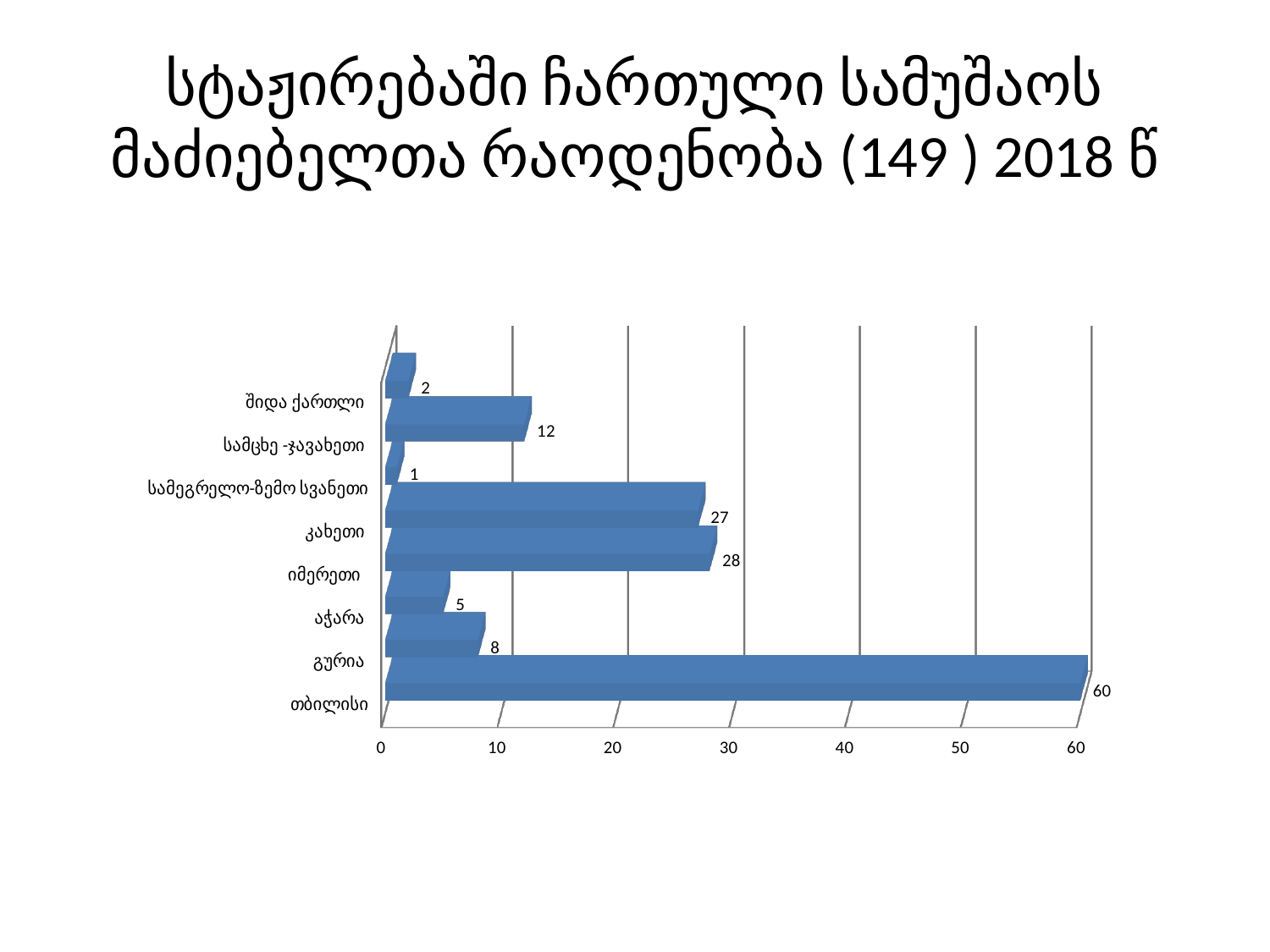
Which category has the lowest value? სამეგრელო-ზემო სვანეთი What is the value for სამცხე-ჯავახეთი? 12 What is the value for გურია? 8 What is the value for იმერეთი? 28 Is the value for კახეთი greater or less than 20? greater What is the value for თბილისი? 60 Which category has the highest value? თბილისი What is the difference between the values for თბილისი and იმერეთი? 32 What type of chart is shown on the slide? bar chart Which is larger, the value for აჭარა or the value for გურია? გურია How many categories (regions) are plotted in the chart? 8 What is the difference between the values for სამცხე-ჯავახეთი and შიდა ქართლი? 10